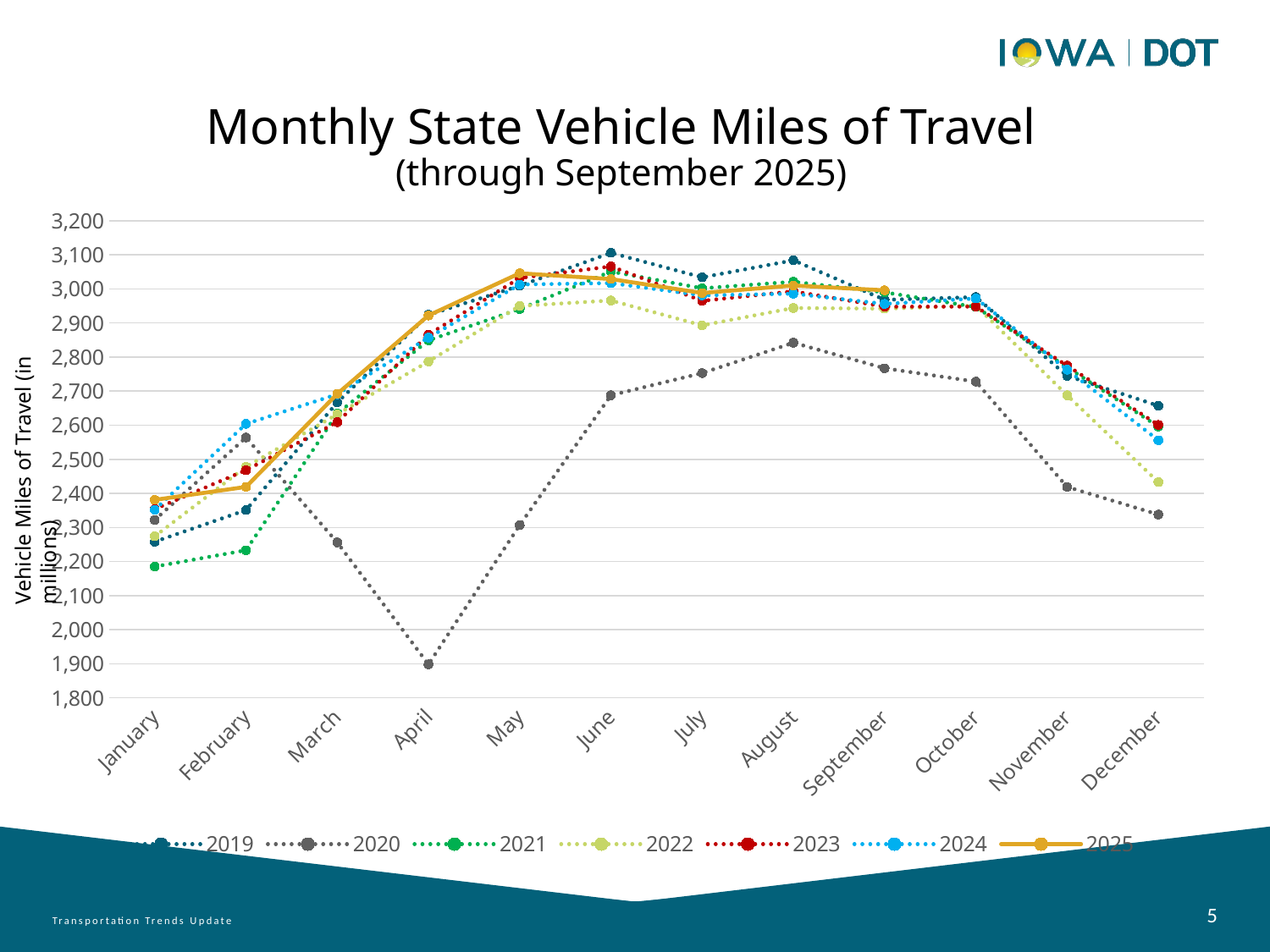
How many months are shown along the x axis? 12 Is the value for 2020 in April greater or less than 2,000? less Which series has the highest value in June? 2019 What is the title of the vertical axis? Vehicle Miles of Travel (in millions) How many series does the legend list? 7 Which series has the lowest value in April? 2020 Does the 2020 series rise or fall from April to August? rise What kind of chart is shown on the slide? line chart In which month does the 2020 series reach its lowest value? April Which series has the lowest value in December? 2020 Which is larger for the 2020 series, the value in March or the value in April? March Is the value for 2025 in January greater or less than 2,300? greater